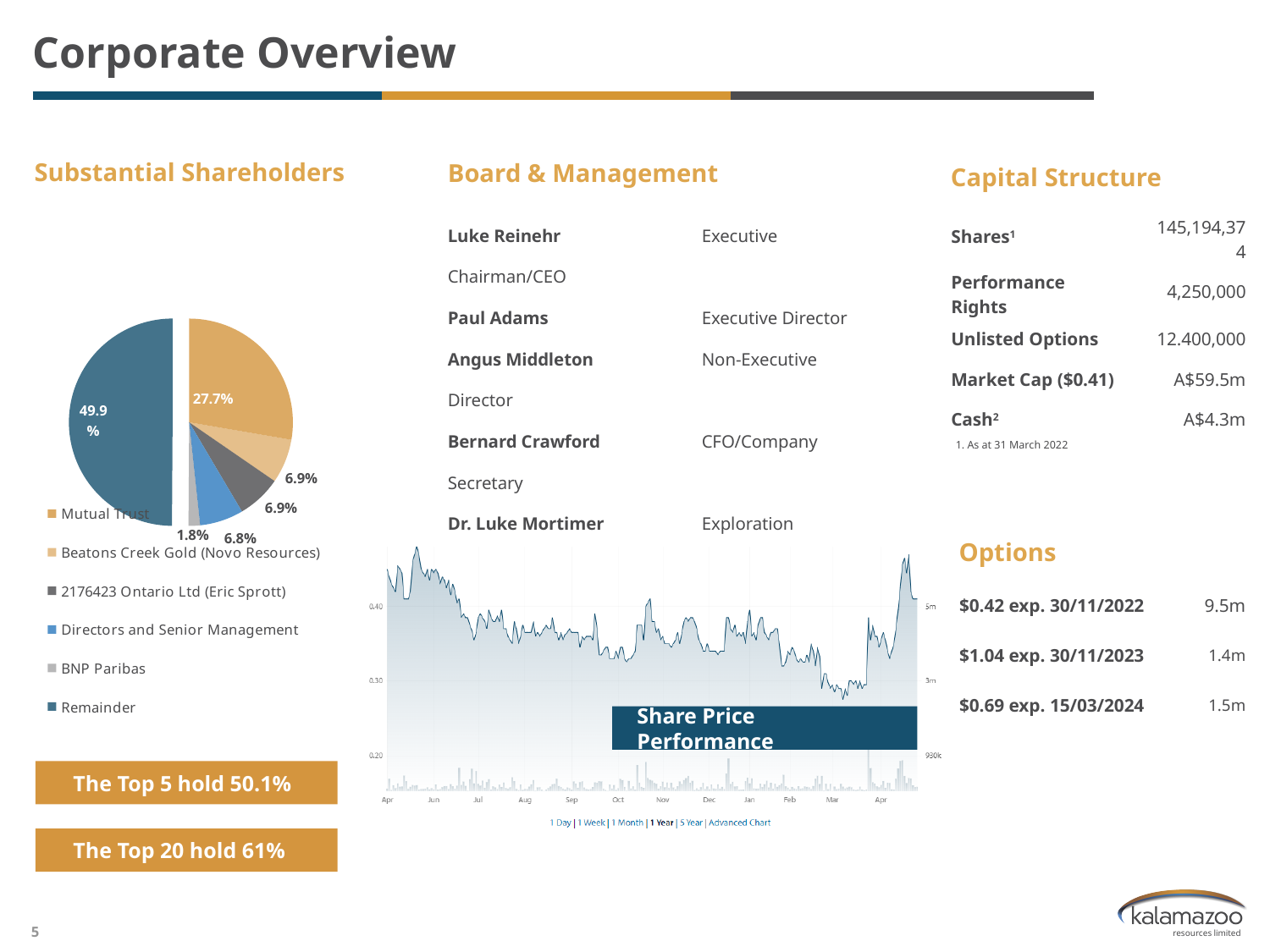
In the Substantial Shareholders pie chart, what share is labelled Remainder? 49.9% In the Substantial Shareholders pie chart, which slice is the largest? Remainder In the Substantial Shareholders pie chart, how many percentage points larger is the Remainder slice than the Mutual Trust slice? 22.2 percentage points In the Substantial Shareholders pie chart, which is larger: Mutual Trust or Directors and Senior Management? Mutual Trust In the Substantial Shareholders pie chart, what share is held by Mutual Trust? 27.7% How many slices does the Substantial Shareholders pie chart have? 6 In the Substantial Shareholders pie chart, what share is held by Directors and Senior Management? 6.8% In the Substantial Shareholders pie chart, which named shareholder has the smallest slice? BNP Paribas What kind of chart is the Substantial Shareholders chart? Pie chart What kind of chart is the Share Price Performance chart? Line chart In the Substantial Shareholders pie chart, what share is held by BNP Paribas? 1.8% How many entries does the legend of the Substantial Shareholders pie chart list? 6